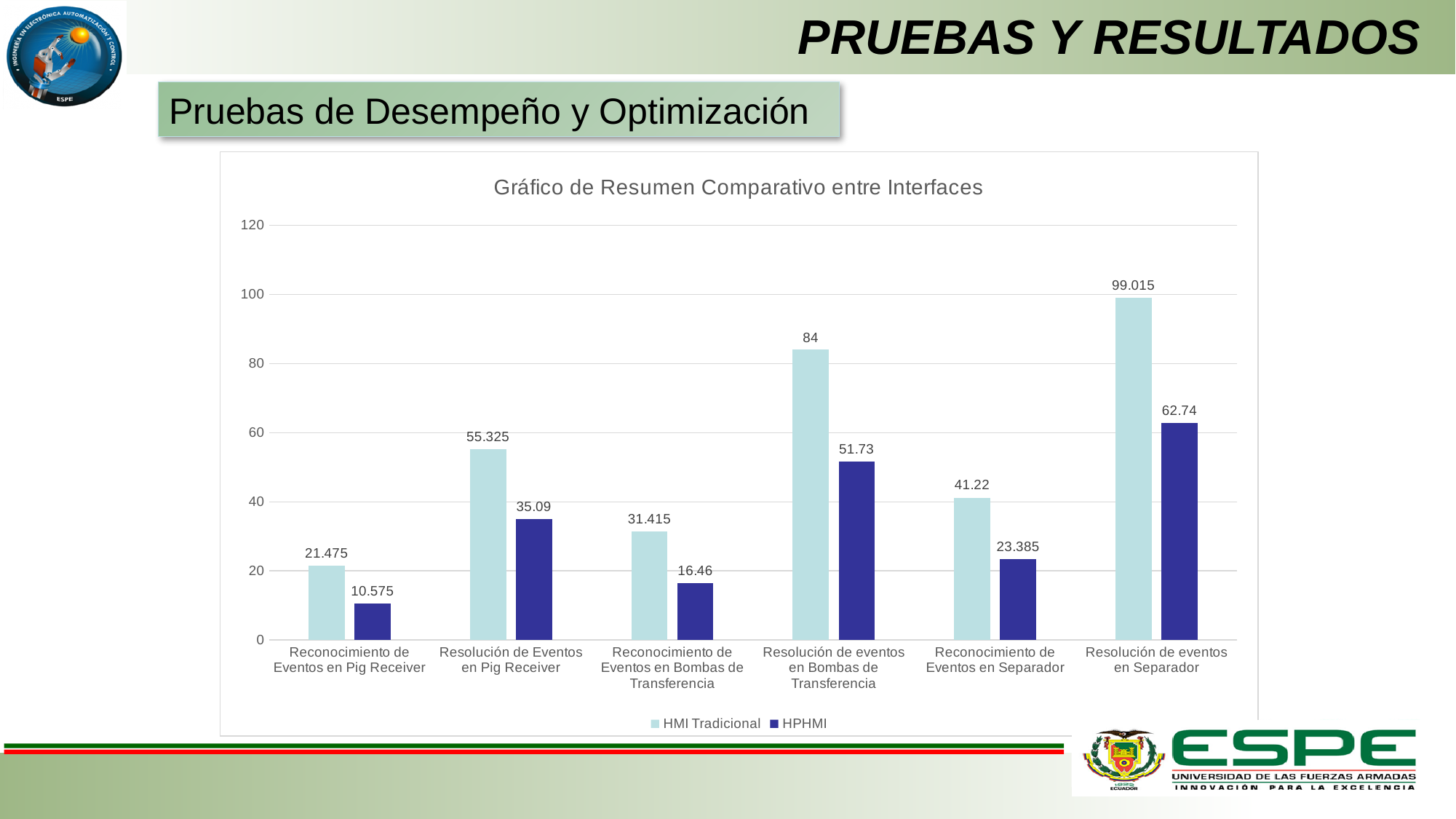
What is the HMI Tradicional value for Resolución de eventos en Separador? 99.015 Which category has the lowest HPHMI value? Reconocimiento de Eventos en Pig Receiver Which category has the highest HMI Tradicional value? Resolución de eventos en Separador Which is larger for Reconocimiento de Eventos en Separador: HMI Tradicional or HPHMI? HMI Tradicional Is the HMI Tradicional value for Resolución de eventos en Bombas de Transferencia greater or less than 80? greater What is the HPHMI value for Resolución de eventos en Bombas de Transferencia? 51.73 What is the difference between the HMI Tradicional and HPHMI values for Resolución de Eventos en Pig Receiver? 20.235 How many categories are shown on the x axis? 6 What kind of chart is shown on the slide? bar chart What is the title of the chart? Gráfico de Resumen Comparativo entre Interfaces How many series does the legend list? 2 What is the HPHMI value for Reconocimiento de Eventos en Pig Receiver? 10.575